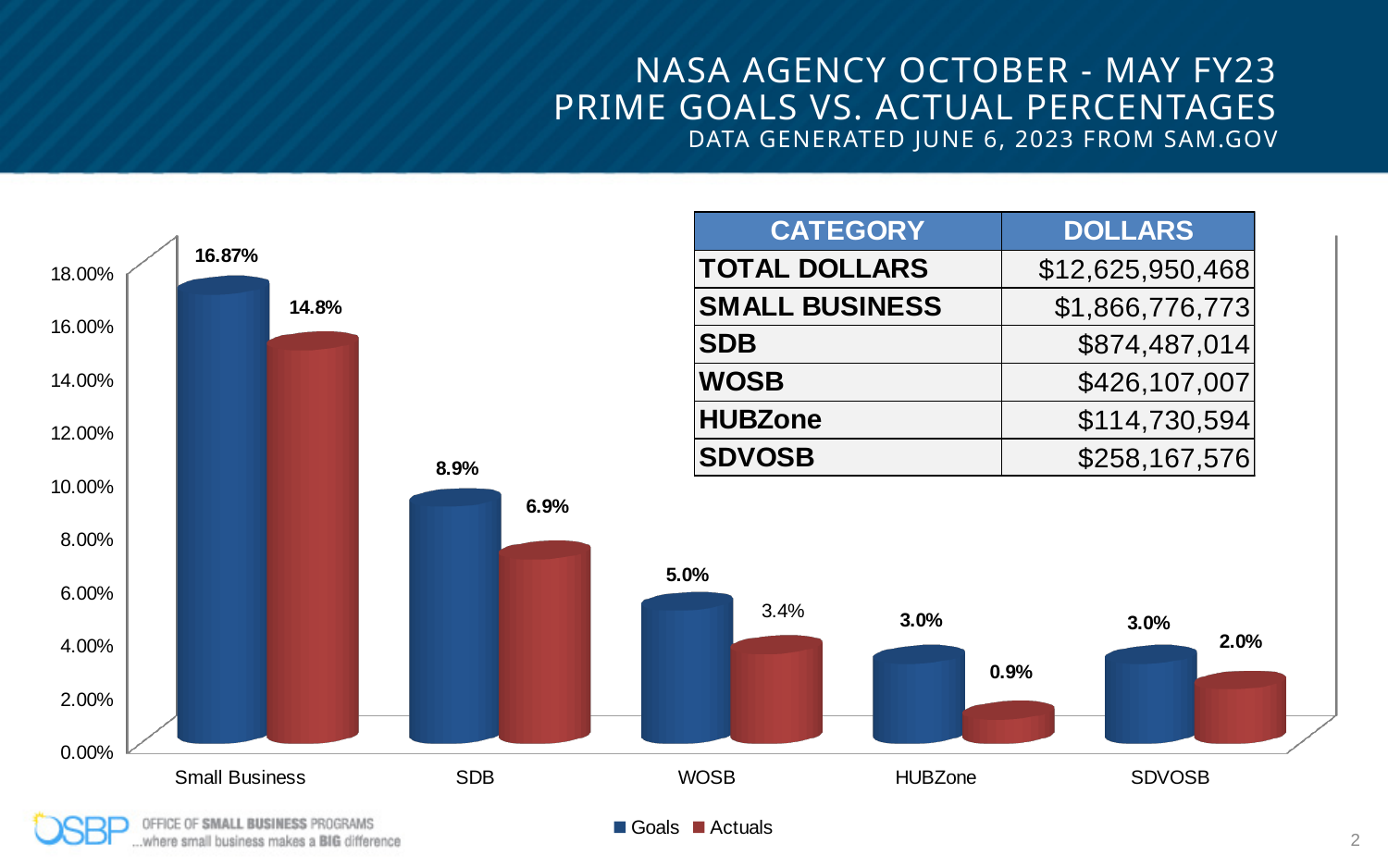
Do the Goals values rise or fall from Small Business to HUBZone along the x axis? Fall Which is larger for SDVOSB, the Goals value or the Actuals value? Goals What is the Actuals value for WOSB? 3.4% How many categories are shown on the x axis? 5 Which category has the lowest Actuals value? HUBZone Which series is shown in red in the legend? Actuals What is the difference between the Goals and Actuals values for SDB? 2.0% What is the Goals value for Small Business? 16.87% How many series does the legend list? 2 Which category has the highest Actuals value? Small Business What kind of chart is shown on the slide? Bar chart What is the Actuals value for HUBZone? 0.9%